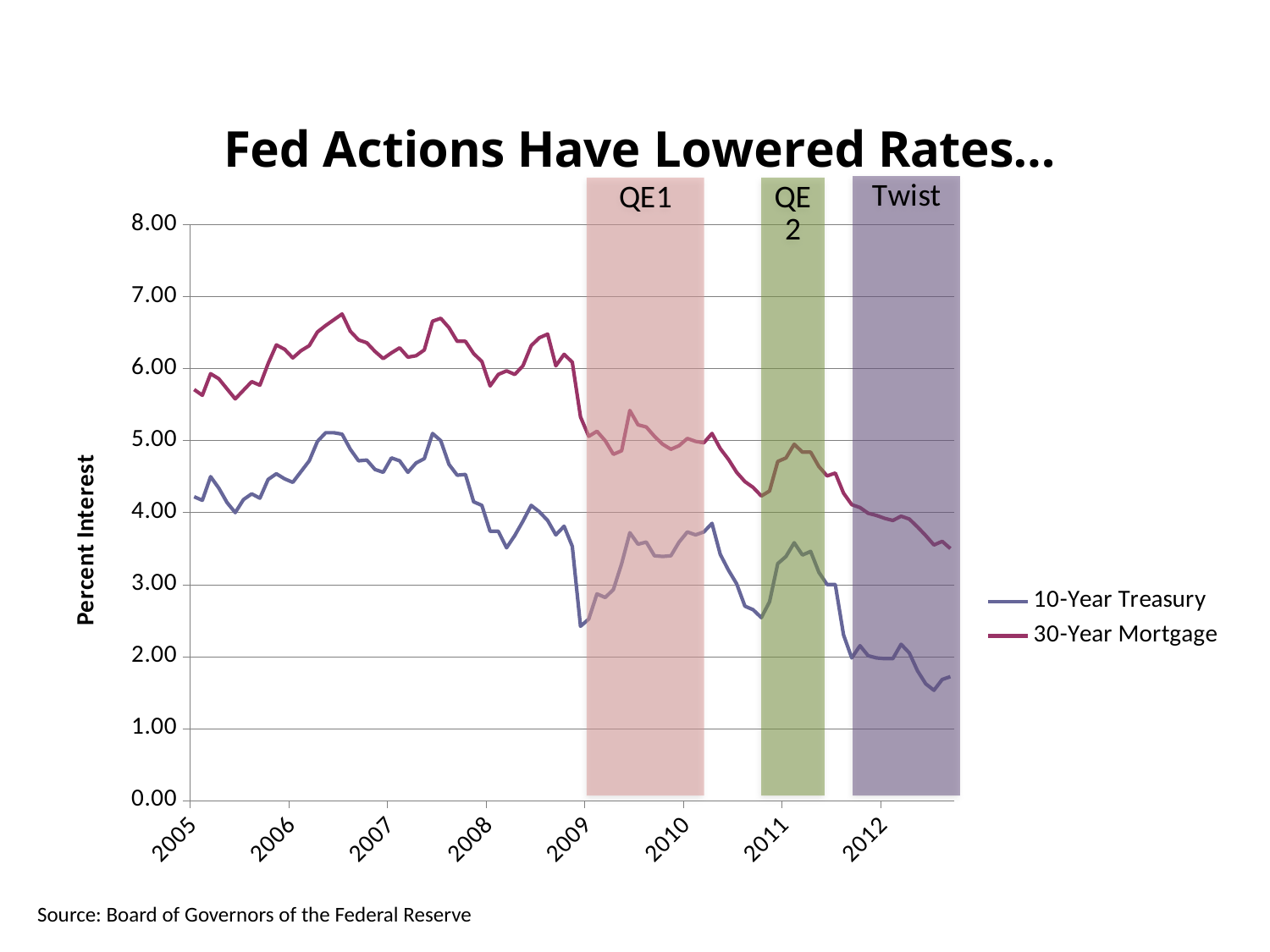
Is the 10-Year Treasury value at the end of 2012 greater or less than 2.00? less What kind of chart is shown on the slide? line chart Overall, do the 10-Year Treasury values rise or fall from 2005 to 2012? fall Which series is higher throughout the chart, 10-Year Treasury or 30-Year Mortgage? 30-Year Mortgage Which two series are listed in the legend? 10-Year Treasury and 30-Year Mortgage What is the title of the chart? Fed Actions Have Lowered Rates... Is the 30-Year Mortgage value at the start of 2005 greater or less than 5.00? greater Overall, do the 30-Year Mortgage values rise or fall from 2005 to 2012? fall Is the 10-Year Treasury value at the start of 2009 greater or less than 3.00? less How many series does the legend list? 2 How many year labels are shown on the x axis? 8